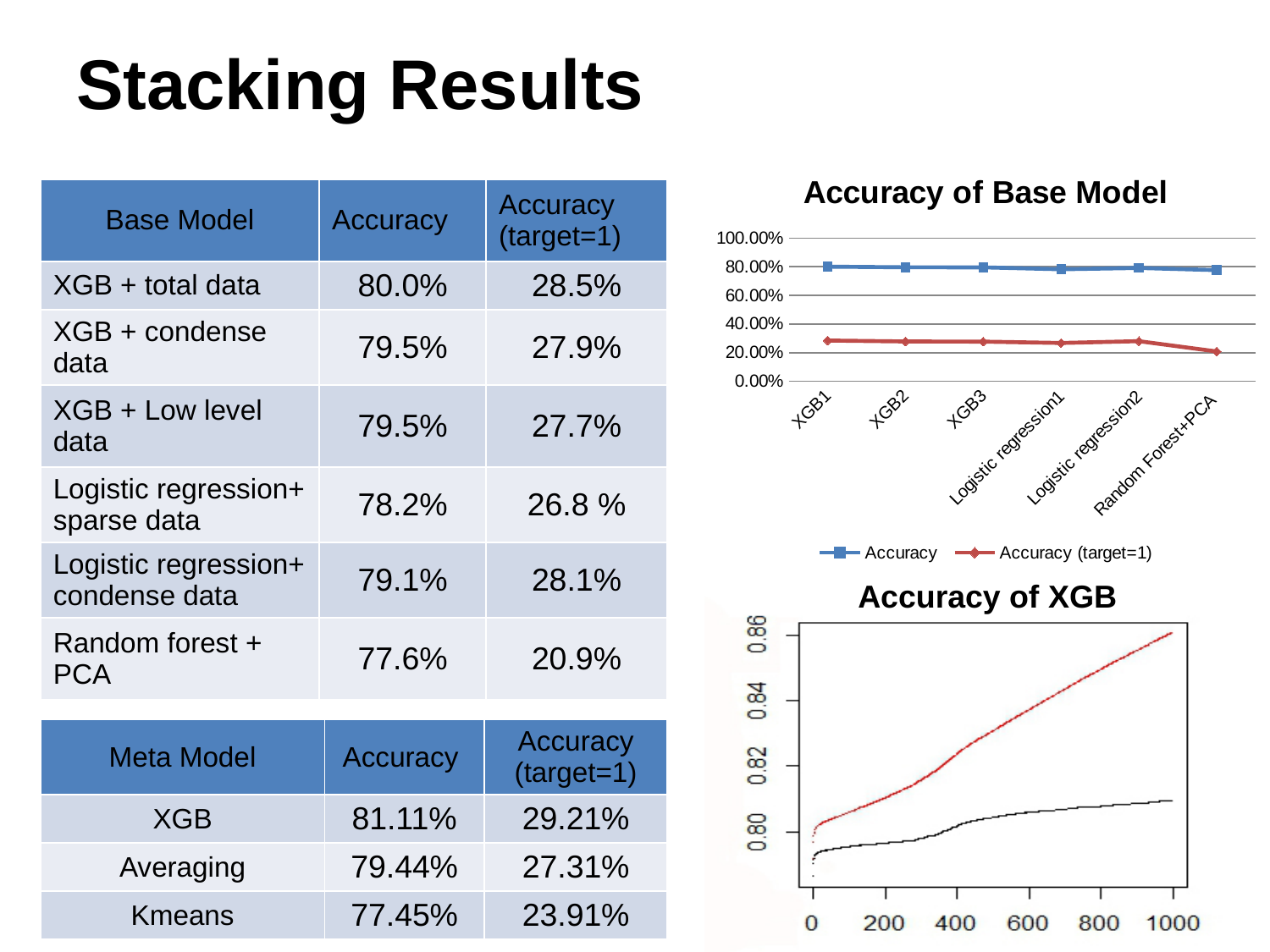
In the "Accuracy of Base Model" chart, which category has the lowest Accuracy (target=1) value? Random Forest+PCA What kind of chart is the "Accuracy of XGB" chart? Line chart How many categories are shown on the x axis of the "Accuracy of Base Model" chart? 6 In the "Accuracy of Base Model" chart, which series has the larger value for XGB1, Accuracy or Accuracy (target=1)? Accuracy In the "Accuracy of Base Model" chart, is the Accuracy value for XGB1 greater or less than 60.00%? greater How many lines are plotted in the "Accuracy of XGB" chart? 2 In the "Accuracy of XGB" chart, does the red line rise or fall as the x axis goes from 0 to 1000? Rise In the "Accuracy of Base Model" chart, is the Accuracy (target=1) value for Random Forest+PCA greater or less than 40.00%? less What kind of chart is the "Accuracy of Base Model" chart? Line chart What are the two legend entries of the "Accuracy of Base Model" chart? Accuracy; Accuracy (target=1) In the "Accuracy of Base Model" chart, does the Accuracy (target=1) line rise or fall from Logistic regression2 to Random Forest+PCA? Fall How many series does the legend of the "Accuracy of Base Model" chart list? 2